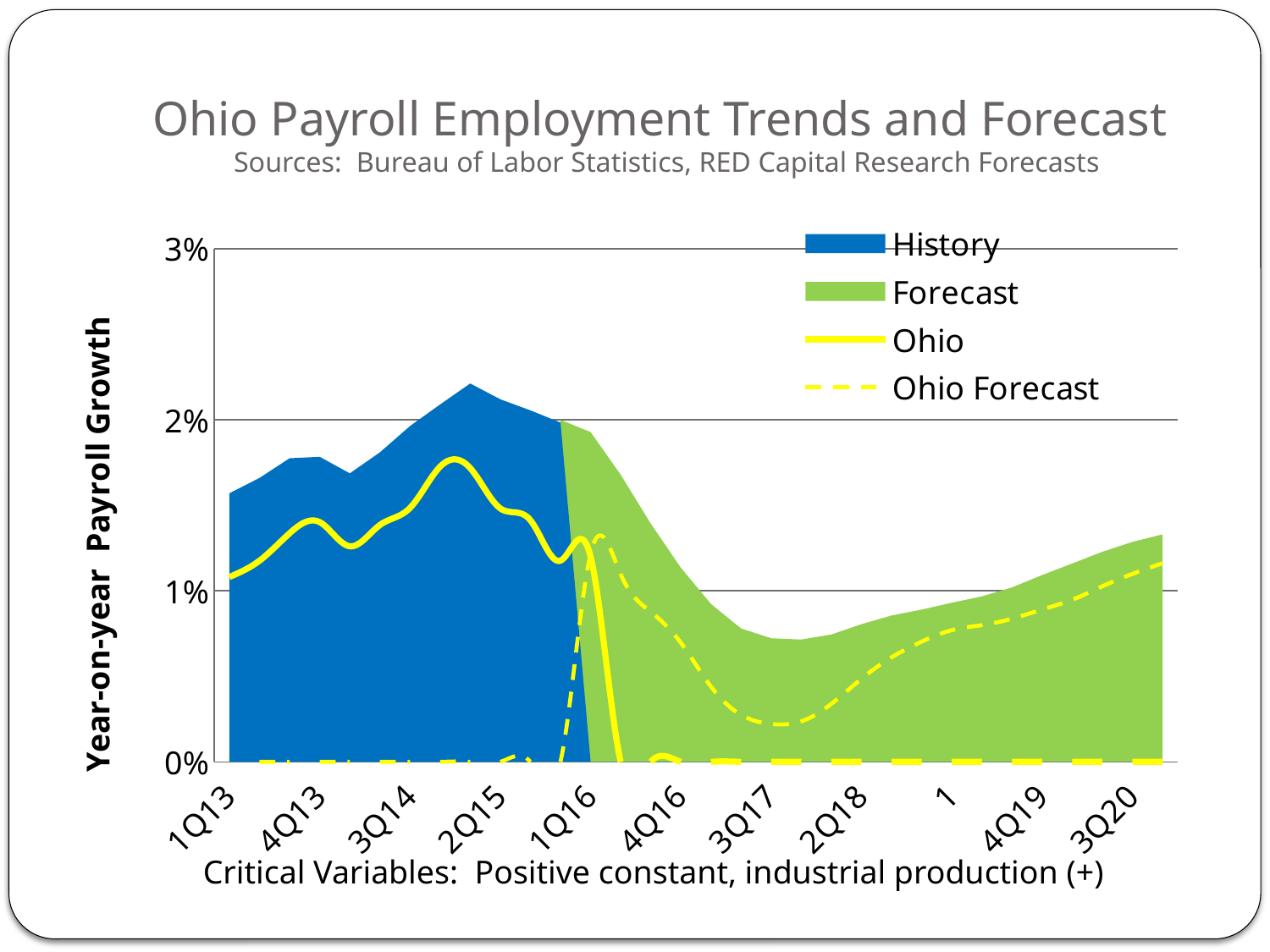
Around which labelled quarter does the Ohio Forecast dashed line reach its lowest point? 3Q17 Which is larger: the History value at 2Q15 or the Forecast value at 3Q17? History at 2Q15 What kind of chart is shown on the slide? Area chart with line series Is the History value at 2Q15 greater or less than 2%? greater Is the Ohio Forecast value at 3Q17 greater or less than 1%? less What is the label on the vertical axis? Year-on-year Payroll Growth What is the title of the chart? Ohio Payroll Employment Trends and Forecast Is the Forecast value at 3Q17 greater or less than 1%? less Does the Forecast area rise or fall between 3Q17 and 3Q20? rise How many series does the legend list? 4